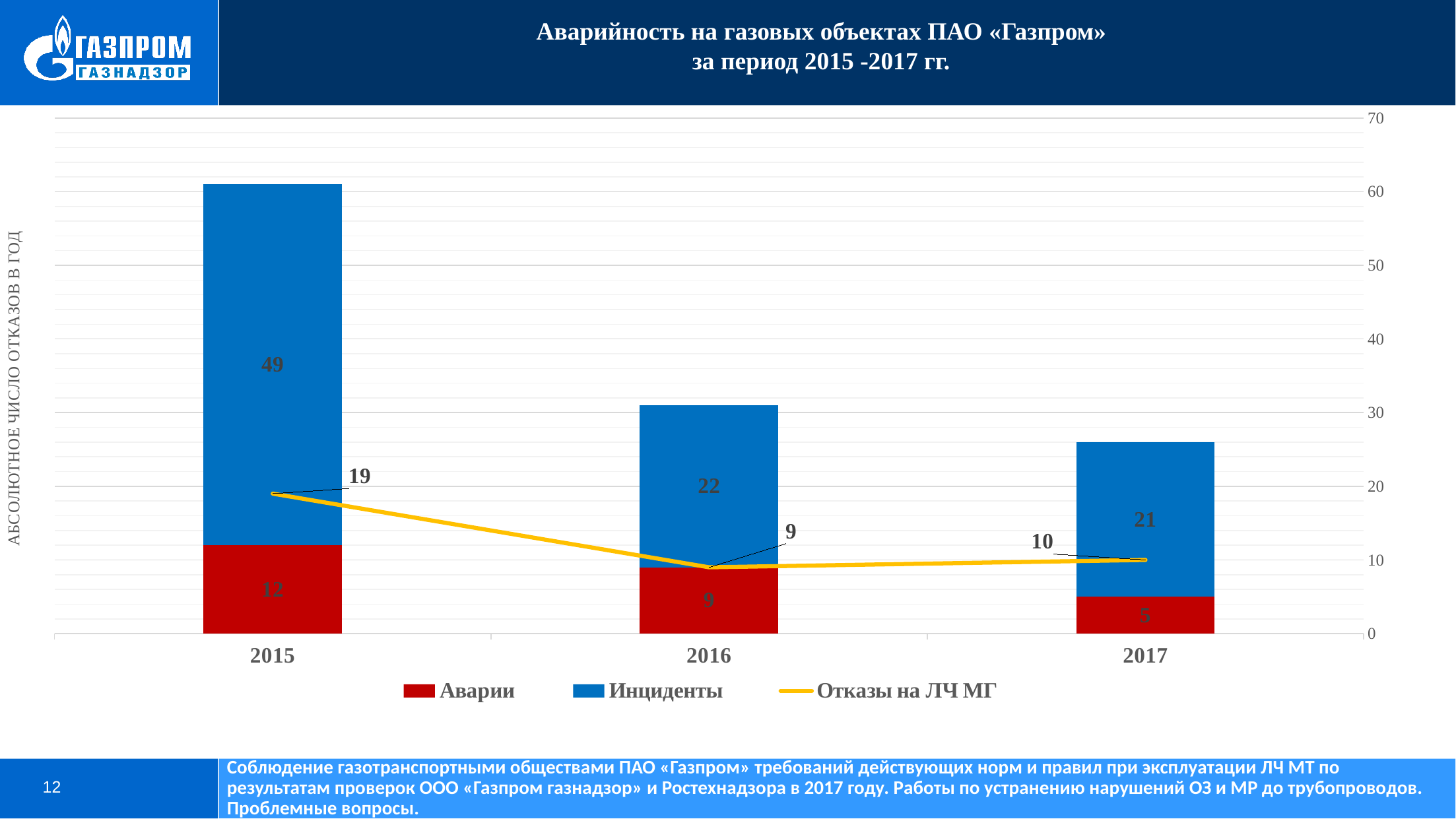
How many years are shown on the x axis? 3 Does the value of Аварии rise or fall from 2015 to 2017? fall What is the value of Аварии for 2015? 12 What is the value of Отказы на ЛЧ МГ for 2016? 9 What is the difference between Инциденты in 2015 and 2016? 27 What is the total of the stacked bar for 2015? 61 Which year has the lowest value for Аварии? 2017 What is the total of the stacked bar for 2017? 26 What is the value of Инциденты for 2017? 21 How many series does the legend list? 3 Which year has the highest value for Инциденты? 2015 Which is larger: Отказы на ЛЧ МГ in 2016 or in 2017? 2017